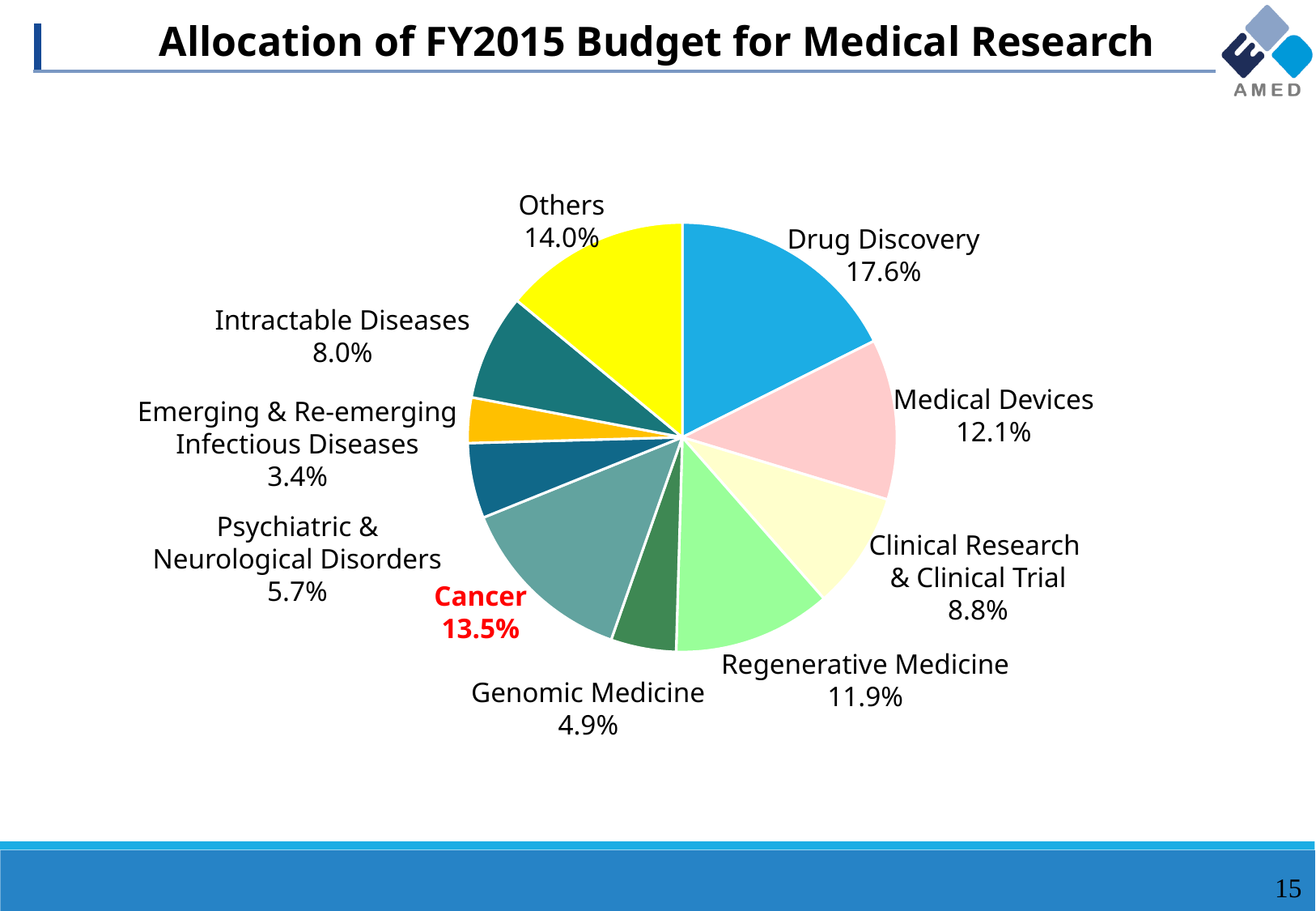
How many categories are shown in the pie chart? 10 Which category has the smallest share of the budget? Emerging & Re-emerging Infectious Diseases What share of the budget is allocated to Drug Discovery? 17.6% Which has a larger share, Intractable Diseases or Psychiatric & Neurological Disorders? Intractable Diseases What is the difference in percentage points between Medical Devices and Clinical Research & Clinical Trial? 3.3 What is the title of the chart? Allocation of FY2015 Budget for Medical Research What share of the budget is allocated to Regenerative Medicine? 11.9% What share of the budget is allocated to Emerging & Re-emerging Infectious Diseases? 3.4% What kind of chart is shown on the slide? pie chart Which category's label is highlighted in red on the chart? Cancer What share of the budget is allocated to Cancer? 13.5% Which category has the largest share of the budget? Drug Discovery